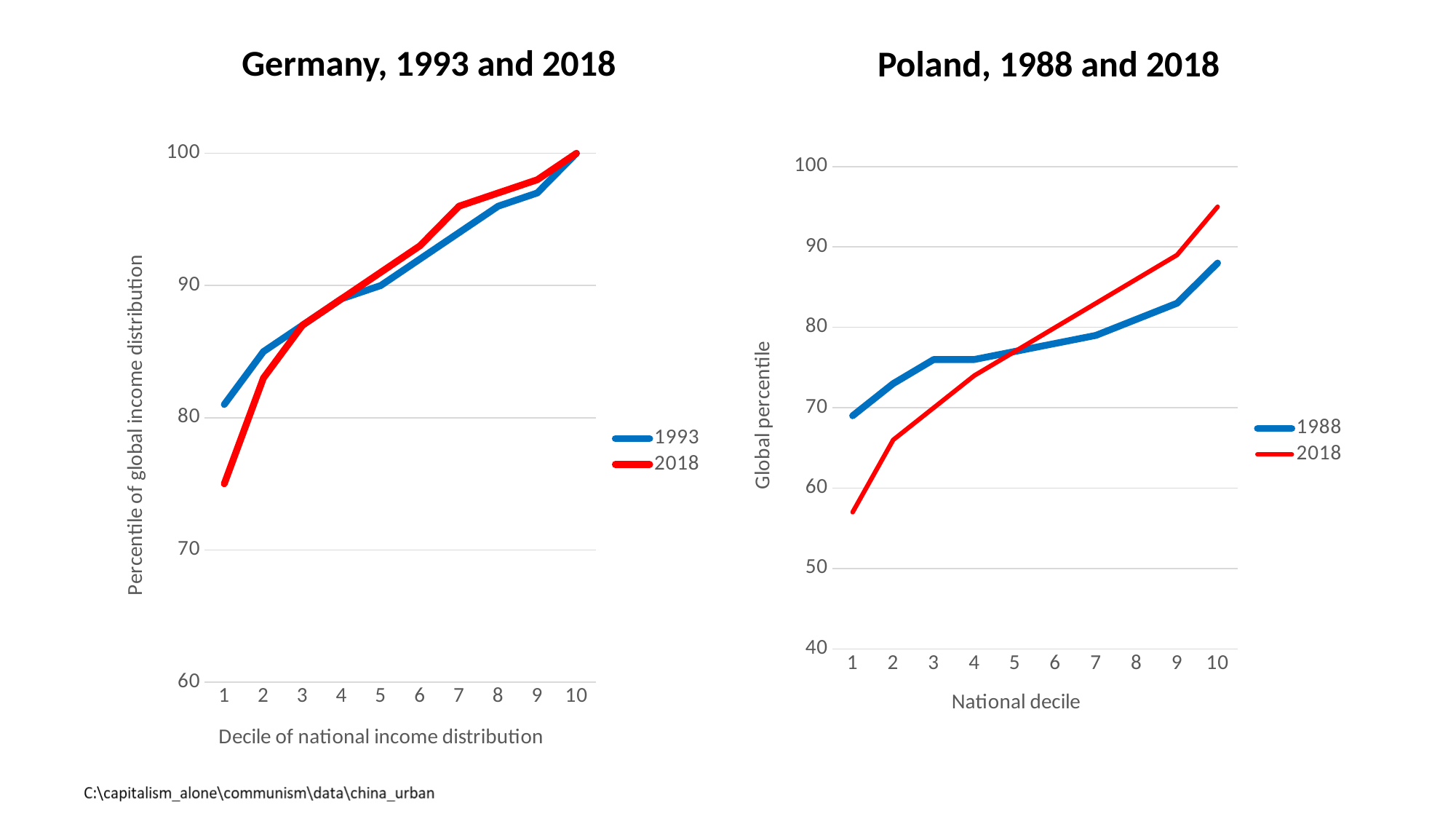
How many series does the legend of the 'Poland, 1988 and 2018' chart list? 2 In the 'Poland, 1988 and 2018' chart, is the value for decile 1 in the 2018 series greater or less than 60? less What kind of chart is the 'Germany, 1993 and 2018' chart? line chart In the 'Poland, 1988 and 2018' chart, which series has the larger value at decile 10, 1988 or 2018? 2018 In the 'Germany, 1993 and 2018' chart, which colour is used for the 1993 series? blue In the 'Germany, 1993 and 2018' chart, which series has the larger value at decile 1, 1993 or 2018? 1993 In the 'Germany, 1993 and 2018' chart, is the value for decile 1 in the 2018 series greater or less than 80? less In the 'Germany, 1993 and 2018' chart, what is the value for decile 10 in the 2018 series? 100 What is the x-axis label of the 'Poland, 1988 and 2018' chart? National decile How many deciles are plotted along the x axis of the 'Germany, 1993 and 2018' chart? 10 In the 'Poland, 1988 and 2018' chart, is the value for decile 10 in the 1988 series greater or less than 90? less In the 'Poland, 1988 and 2018' chart, do the values of the 2018 series rise or fall as the decile increases? rise